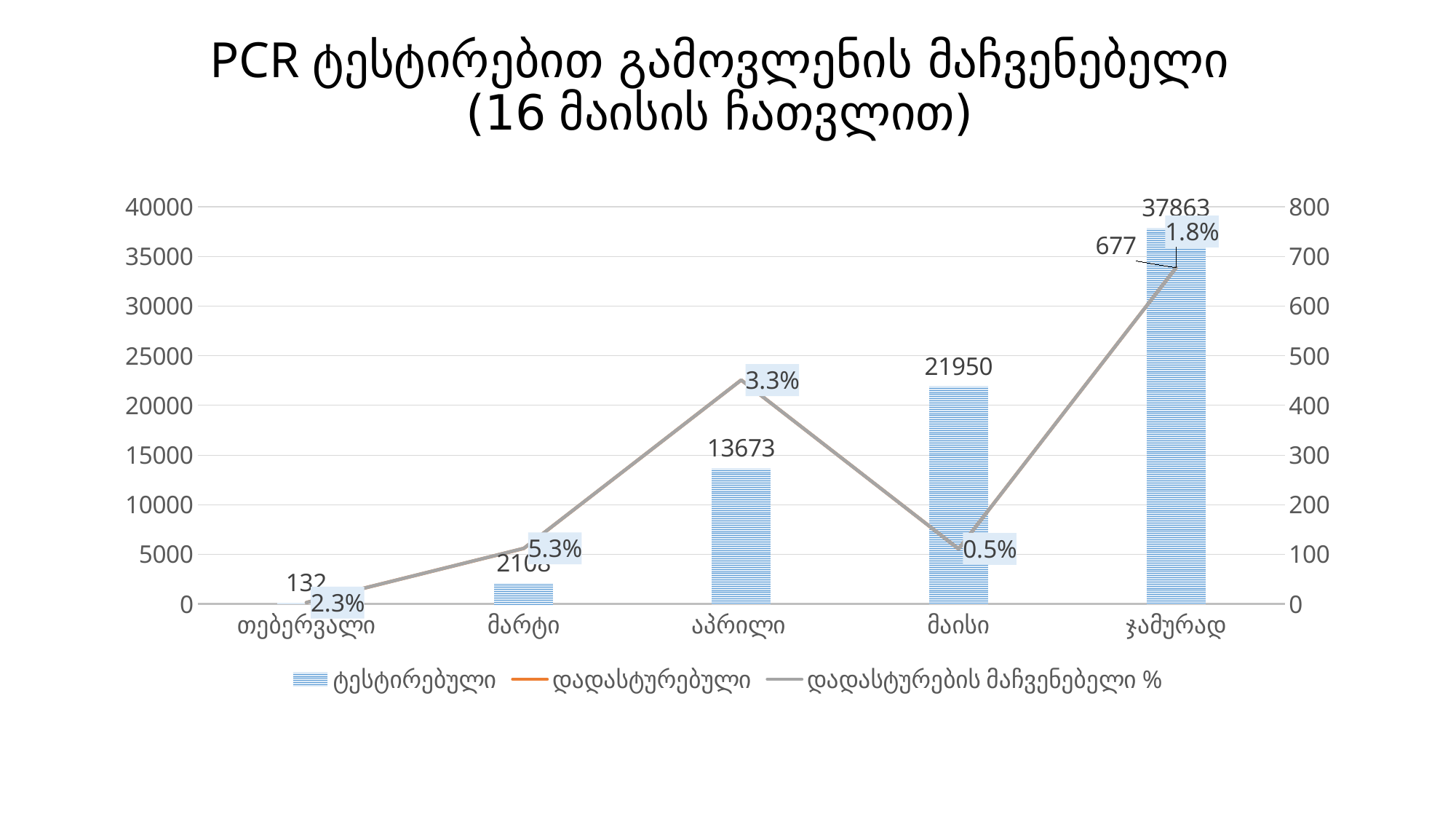
How many series does the legend list? 3 How many categories are shown on the x axis? 5 What is the ტესტირებული value for აპრილი? 13673 What is the difference between the ტესტირებული values for ჯამურად and მაისი? 15913 Which category has the highest დადასტურების მაჩვენებელი % value? მარტი What is the ტესტირებული value for ჯამურად? 37863 Which category has the lowest დადასტურების მაჩვენებელი % value? მაისი Is the ტესტირებული value for აპრილი greater or less than 15000? less What is the დადასტურების მაჩვენებელი % value for მაისი? 0.5% Which category has the highest ტესტირებული value? ჯამურად What is the ტესტირებული value for მაისი? 21950 What is the დადასტურების მაჩვენებელი % value for მარტი? 5.3%